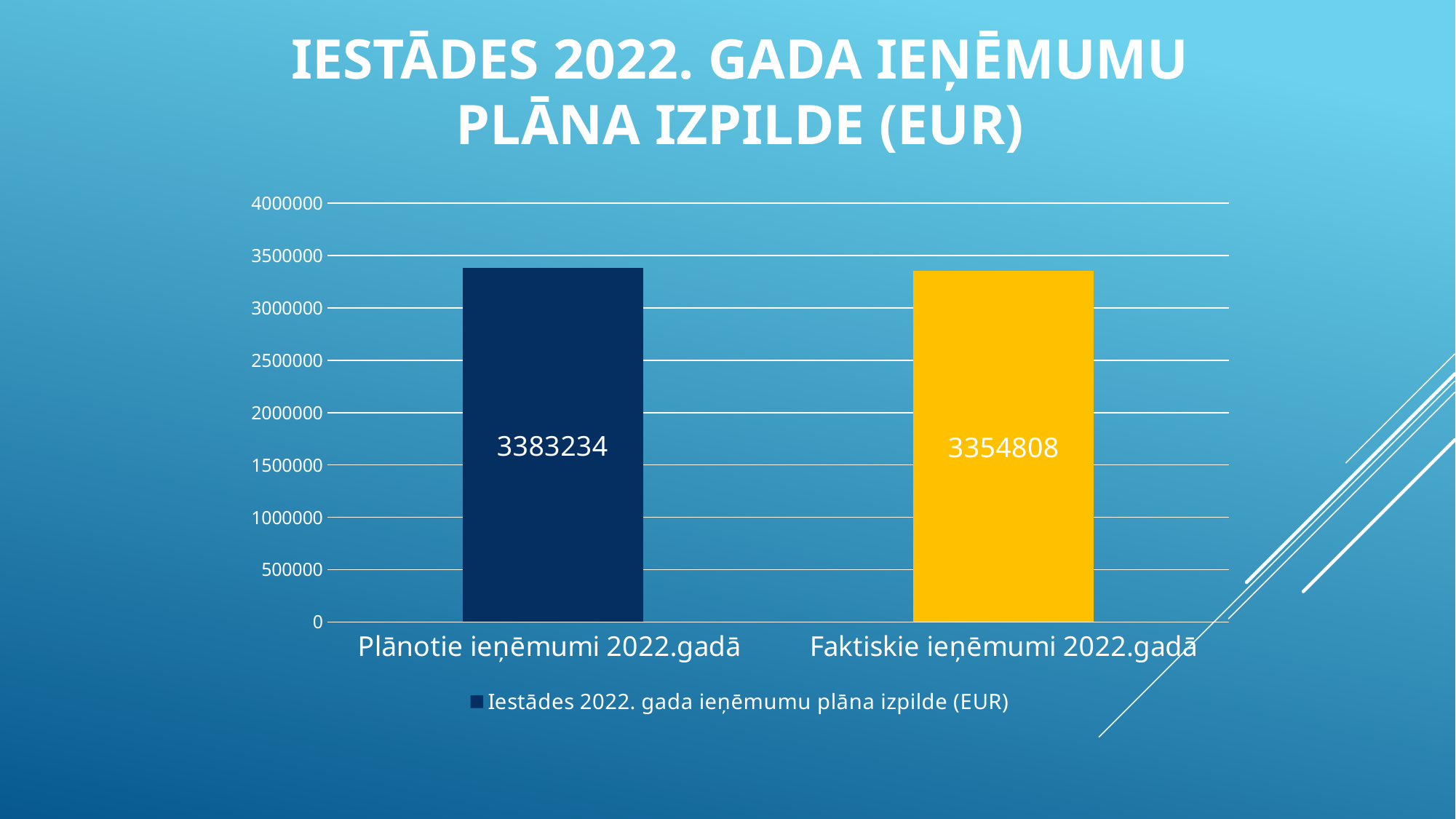
How many series does the legend list? 1 What is the value for Faktiskie ieņēmumi 2022.gadā? 3354808 Is the value for Faktiskie ieņēmumi 2022.gadā larger or smaller than the value for Plānotie ieņēmumi 2022.gadā? smaller Which category has the lower value? Faktiskie ieņēmumi 2022.gadā What kind of chart is shown on the slide? bar chart What is the difference between the value for Plānotie ieņēmumi 2022.gadā and the value for Faktiskie ieņēmumi 2022.gadā? 28426 Is the value for Plānotie ieņēmumi 2022.gadā greater or less than 3500000? less What is the value for Plānotie ieņēmumi 2022.gadā? 3383234 What is the title of the chart? Iestādes 2022. gada ieņēmumu plāna izpilde (EUR) How many categories are shown on the x axis? 2 Which category has the higher value? Plānotie ieņēmumi 2022.gadā Is the value for Faktiskie ieņēmumi 2022.gadā greater or less than 3000000? greater